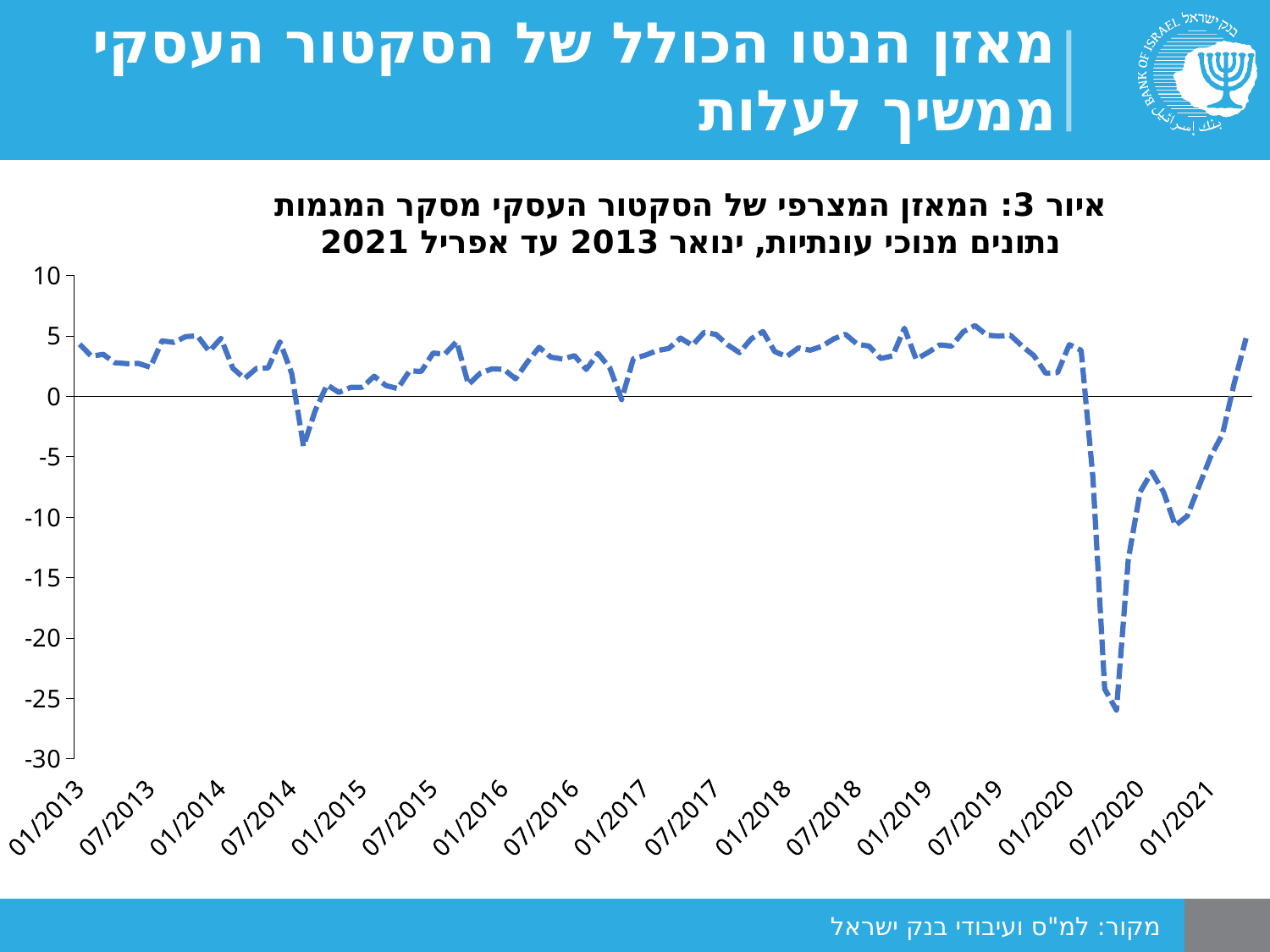
Between 01/2020 and 07/2020, does the line rise or fall? Fall Is the value of the line at 01/2013 greater or less than 0? greater Is the value of the line at 01/2019 greater or less than 0? greater How many labelled tick marks are there on the horizontal (date) axis? 17 From 07/2020 to the end of the series, does the line generally rise or fall? Rise Which is larger, the value of the line at 01/2013 or at 07/2020? 01/2013 Around which date label does the line reach its lowest point? 07/2020 What is the lowest value shown on the vertical axis of the chart? -30 Is the value of the line at 01/2021 greater or less than 0? less What kind of chart is shown on the slide? Line chart What is the figure number given in the chart title? איור 3